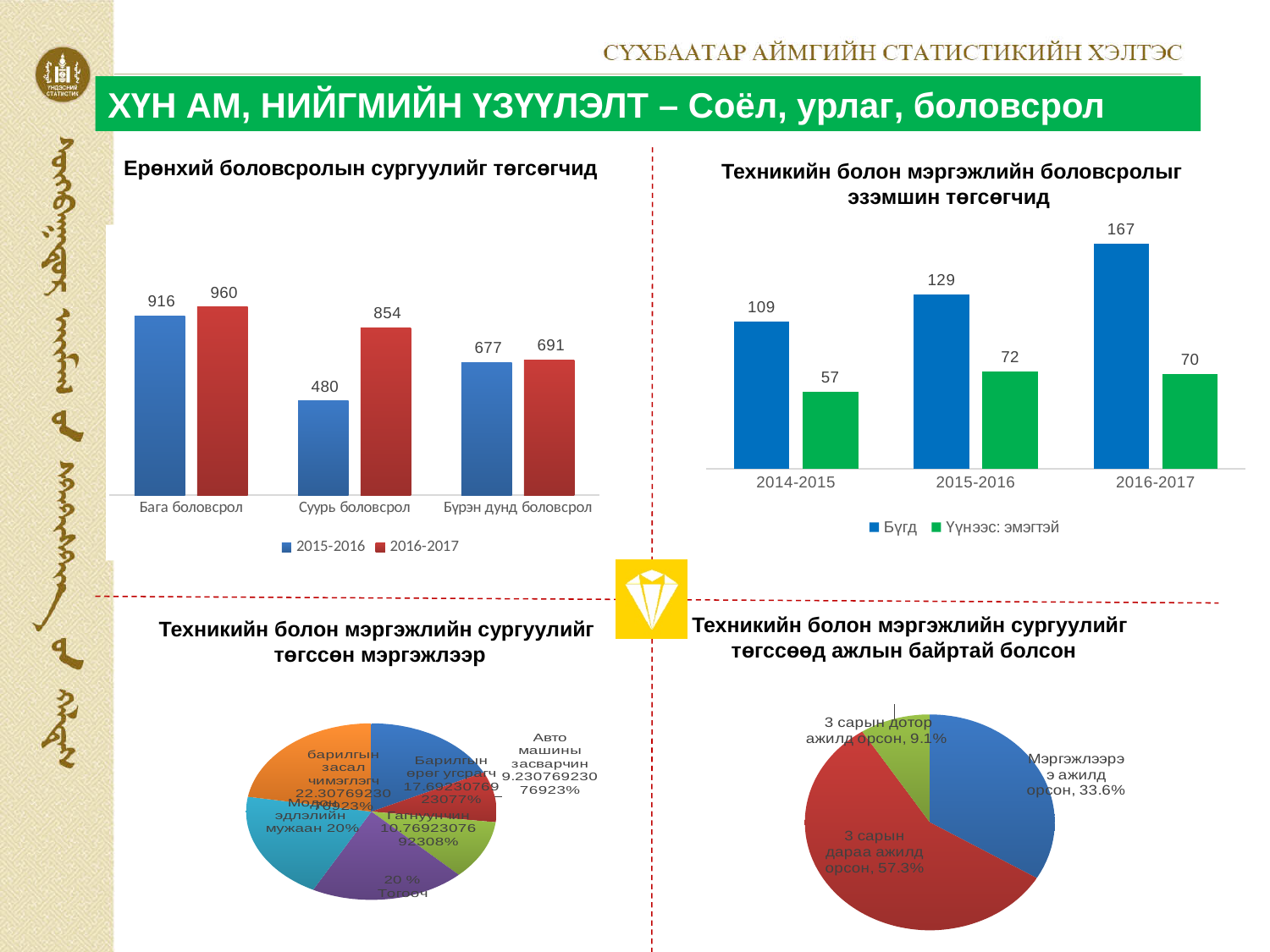
In the pie chart 'Техникийн болон мэргэжлийн сургуулийг төгссөөд ажлын байртай болсон', which slice is the smallest? 3 сарын дотор ажилд орсон In the chart 'Ерөнхий боловсролын сургуулийг төгсөгчид', what is the value for Бүрэн дунд боловсрол in 2015-2016? 677 In the chart 'Техникийн болон мэргэжлийн боловсролыг эзэмшин төгсөгчид', which year has the lowest Үүнээс: эмэгтэй value? 2014-2015 What kind of chart is 'Техникийн болон мэргэжлийн боловсролыг эзэмшин төгсөгчид'? bar chart In the pie chart 'Техникийн болон мэргэжлийн сургуулийг төгссөөд ажлын байртай болсон', what share is '3 сарын дараа ажилд орсон'? 57.3% In the chart 'Ерөнхий боловсролын сургуулийг төгсөгчид', what is the difference between the 2016-2017 and 2015-2016 values for Суурь боловсрол? 374 In the chart 'Техникийн болон мэргэжлийн боловсролыг эзэмшин төгсөгчид', does the Бүгд series rise or fall from 2014-2015 to 2016-2017? rise In the chart 'Ерөнхий боловсролын сургуулийг төгсөгчид', what is the value for Суурь боловсрол in 2016-2017? 854 In the chart 'Техникийн болон мэргэжлийн боловсролыг эзэмшин төгсөгчид', what is the Үүнээс: эмэгтэй value for 2014-2015? 57 In the chart 'Ерөнхий боловсролын сургуулийг төгсөгчид', which category has the highest 2016-2017 value? Бага боловсрол In the chart 'Ерөнхий боловсролын сургуулийг төгсөгчид', how many series does the legend list? 2 In the chart 'Техникийн болон мэргэжлийн боловсролыг эзэмшин төгсөгчид', what is the Бүгд value for 2016-2017? 167